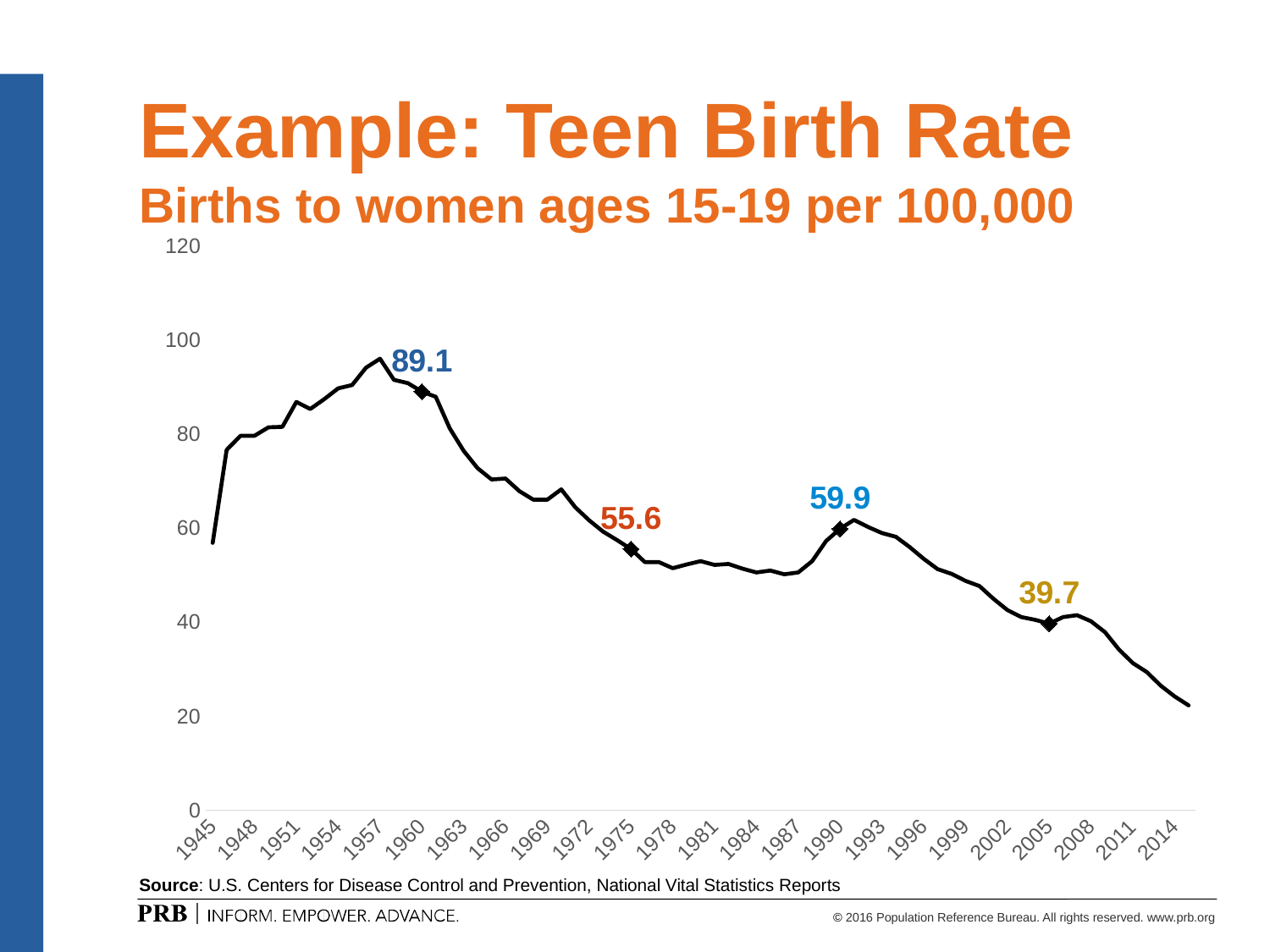
What value is labeled on the line at 1975? 55.6 What kind of chart is shown on the slide? line chart What is the difference between the labeled values for 1990 and 1975? 4.3 Of the four labeled points, which year has the highest value? 1960 Which year has the larger labeled value, 1975 or 1990? 1990 What is the labeled value for 2005? 39.7 What is the labeled value for 1990? 59.9 Is the value for 2014 greater or less than 40? less Does the teen birth rate rise or fall from 1990 to 2014? fall What is the difference between the labeled values for 1960 and 2005? 49.4 Of the four labeled points, which year has the lowest value? 2005 What is the teen birth rate labeled for 1960? 89.1